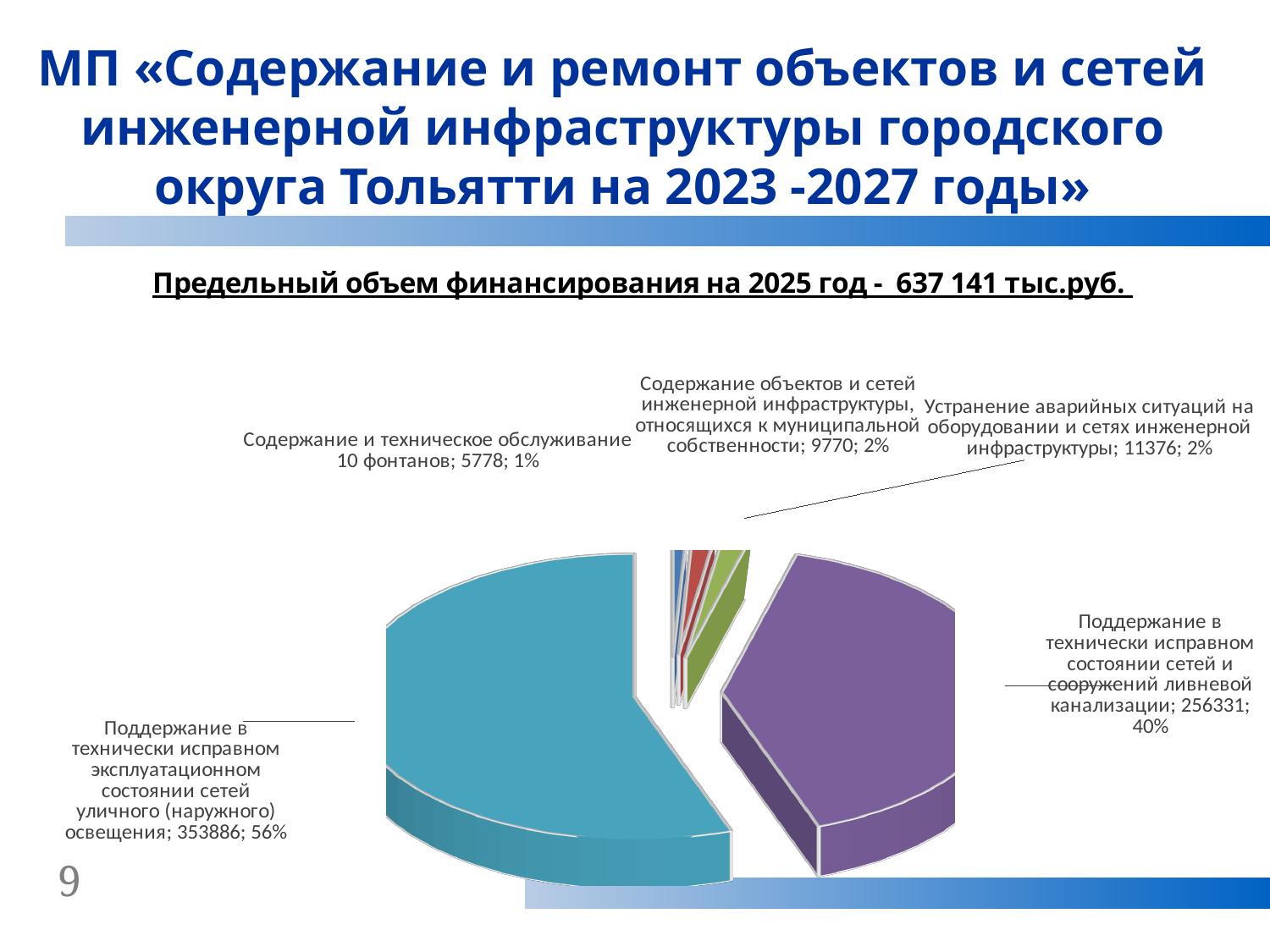
Сколько секторов (категорий) содержит круговая диаграмма? 5 Какое значение указано для категории «Устранение аварийных ситуаций на оборудовании и сетях инженерной инфраструктуры»? 11376 Какую долю составляет сектор «Содержание объектов и сетей инженерной инфраструктуры, относящихся к муниципальной собственности»? 2% Какая категория имеет наибольшую долю на диаграмме? Поддержание в технически исправном эксплуатационном состоянии сетей уличного (наружного) освещения Что больше: значение для устранения аварийных ситуаций или значение для содержания и технического обслуживания 10 фонтанов? Устранение аварийных ситуаций на оборудовании и сетях инженерной инфраструктуры Какое значение указано для категории «Поддержание в технически исправном состоянии сетей и сооружений ливневой канализации»? 256331 Какую долю составляет сектор «Поддержание в технически исправном состоянии сетей и сооружений ливневой канализации»? 40% На сколько значение для сетей уличного (наружного) освещения больше значения для сетей и сооружений ливневой канализации? 97555 Какая категория имеет наименьшую долю на диаграмме? Содержание и техническое обслуживание 10 фонтанов Какое значение указано для категории «Поддержание в технически исправном эксплуатационном состоянии сетей уличного (наружного) освещения»? 353886 Какой тип диаграммы показан на слайде? Круговая диаграмма Какое значение указано для категории «Содержание и техническое обслуживание 10 фонтанов»? 5778